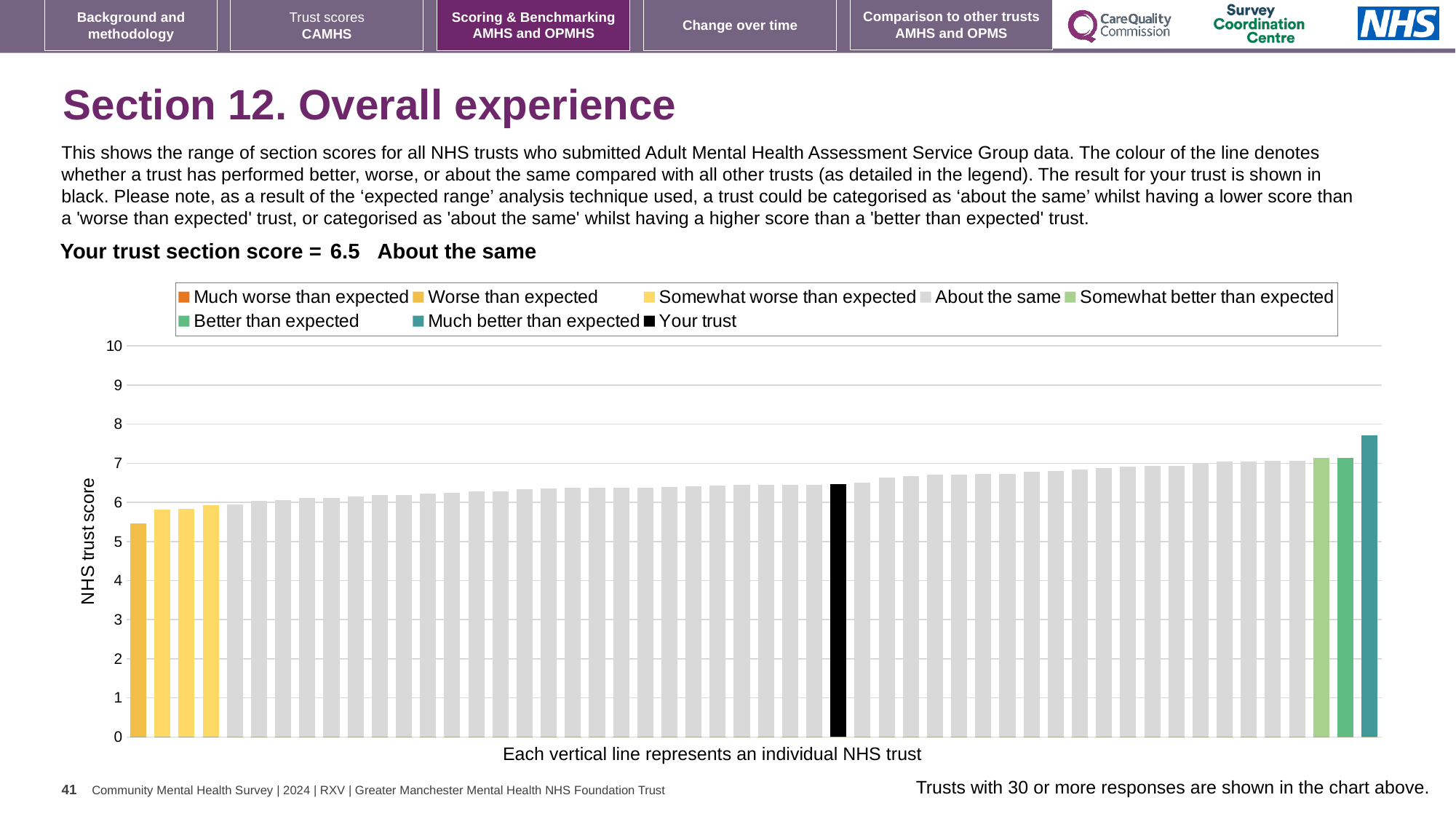
Is the value of the black 'Your trust' bar greater or less than 6? greater How many entries does the chart legend list? 8 Is the value of the tallest bar in the chart greater or less than 7? greater What is the label on the vertical axis of the chart? NHS trust score Do the bar values rise or fall from left to right along the x axis? rise Which legend category does the tallest bar in the chart belong to? Much better than expected What kind of chart is shown on the slide? bar chart What is the section score for your trust, as printed on the slide? 6.5 Which is larger: the score of your trust or the score of the 'Much better than expected' trust? Much better than expected trust How many bars are coloured as 'Much better than expected'? 1 Is the value of the shortest bar in the chart greater or less than 6? less